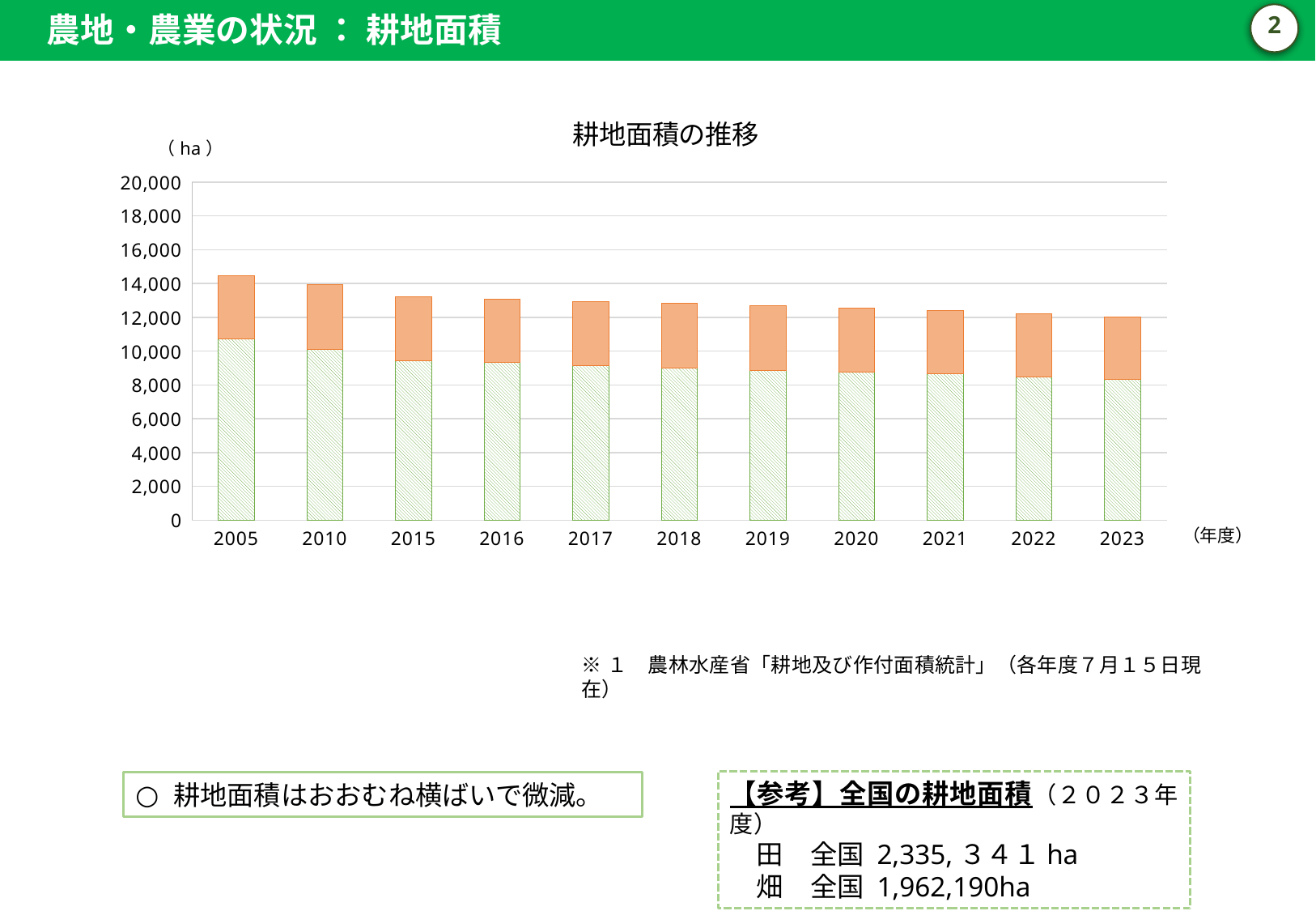
How many years are shown on the x axis of the chart? 11 Is the lower (green hatched) segment for 2005 greater or less than 10,000? greater Is the lower (green hatched) segment for 2023 greater or less than 10,000? less Which year has the highest total bar in the chart? 2005 What is the title of the chart? 耕地面積の推移 Is the total bar for 2005 greater or less than 14,000? greater What unit is shown on the vertical axis of the chart? ha Which has the larger total bar, 2005 or 2023? 2005 Do the total bar heights rise or fall from 2005 to 2023? fall What kind of chart is shown on the slide? stacked bar chart